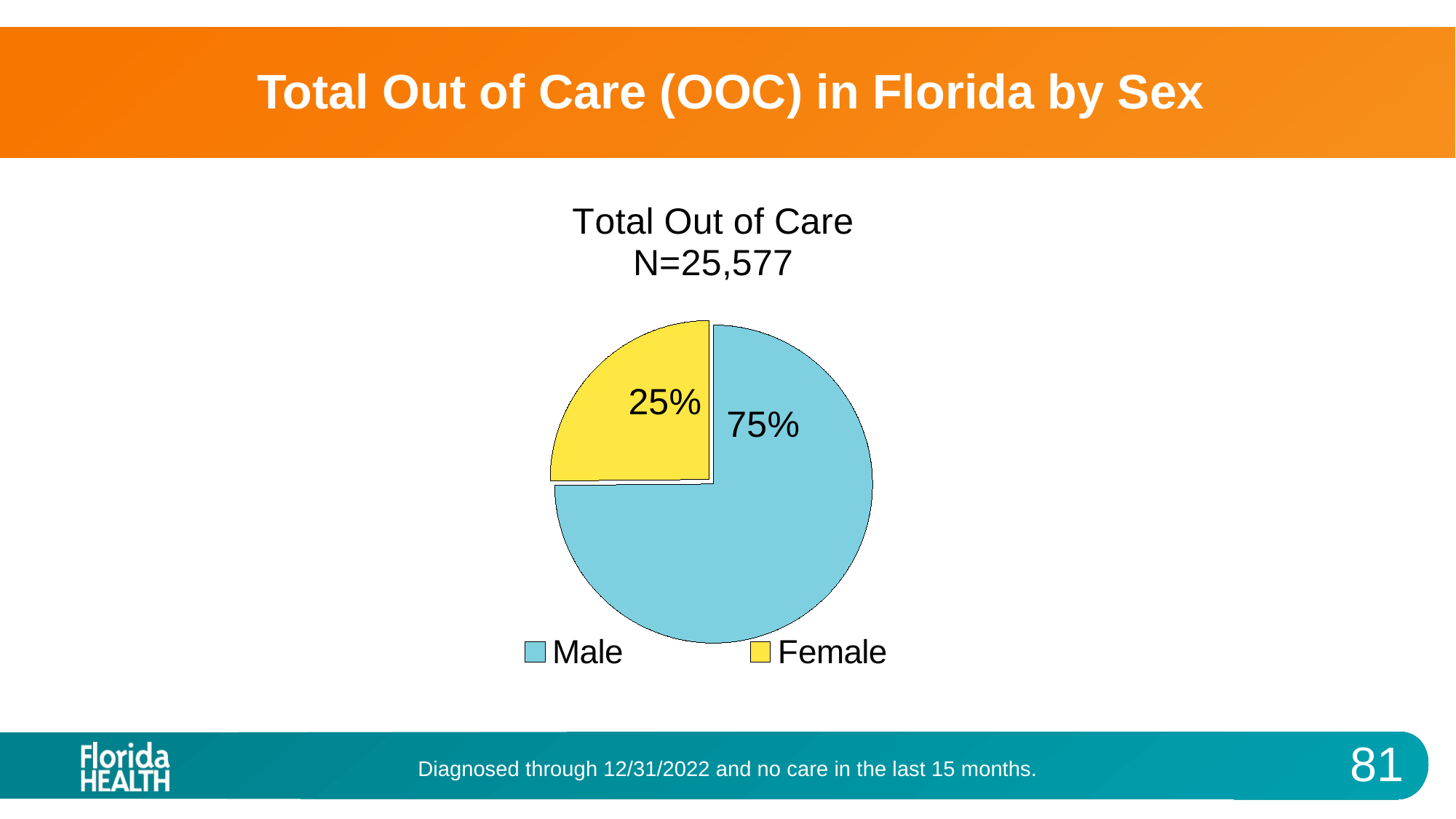
Which category has the smallest slice of the pie? Female What share of the pie does Female represent? 25% What is the difference in percentage points between the Male and Female slices? 50 What is the total N shown in the chart title? 25,577 How many slices does the pie chart have? 2 What kind of chart is shown on the slide? Pie chart Which category has the largest slice of the pie? Male What share of the pie does Male represent? 75% Which colour represents Female in the pie chart? Yellow Is the Male share greater or less than 50%? greater Which slice is larger, Male or Female? Male